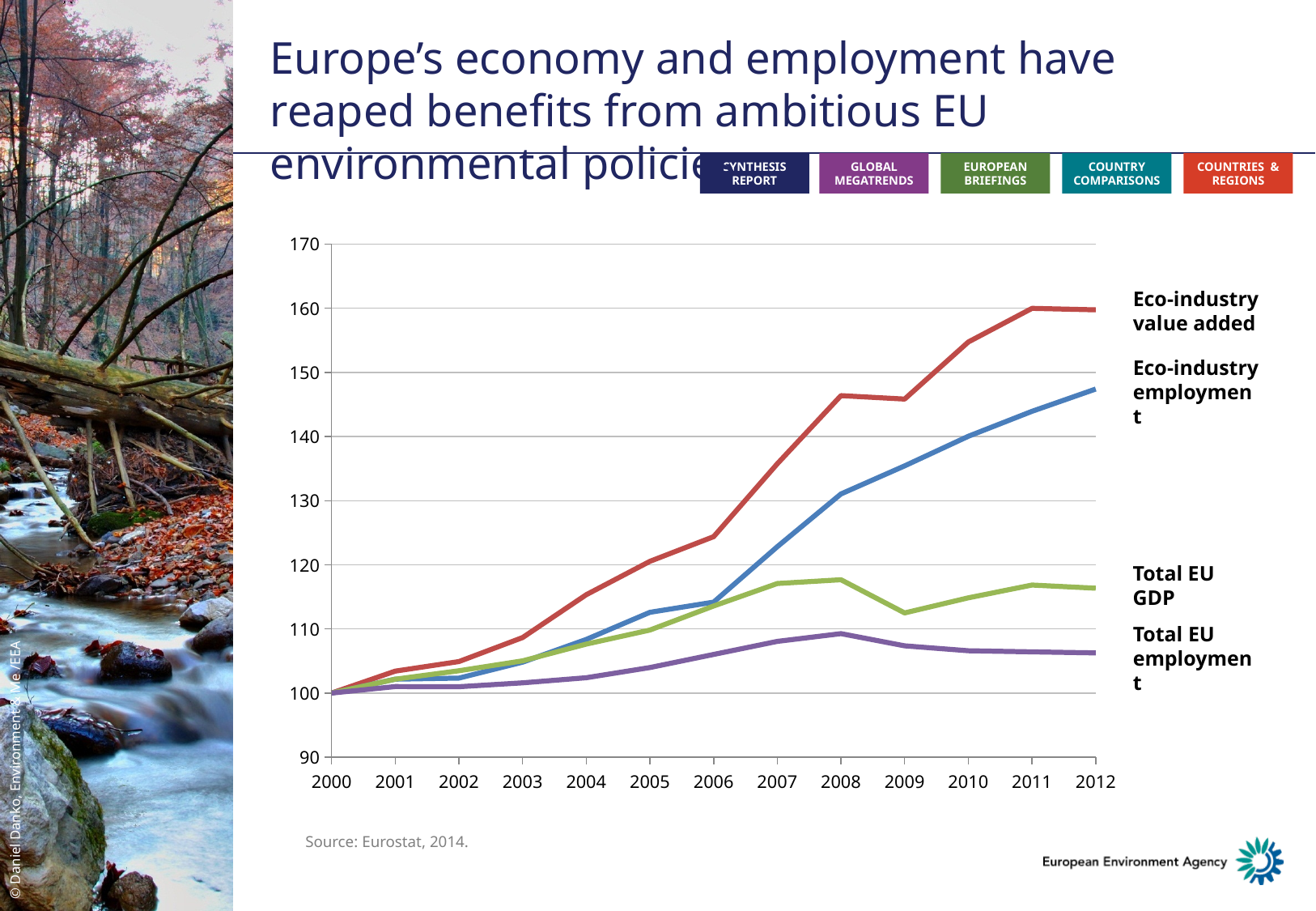
Is the value for Eco-industry employment in 2012 greater or less than 140? greater What kind of chart is shown on the slide? Line chart Which series has the highest value in 2012? Eco-industry value added Which series has the lowest value in 2012? Total EU employment Does Eco-industry value added rise or fall overall from 2000 to 2012? Rise How many series does the chart show? 4 Is the value for Eco-industry value added in 2012 greater or less than 150? greater In 2012, which is larger: Eco-industry employment or Total EU GDP? Eco-industry employment Is the value for Total EU GDP in 2008 greater or less than 120? less What source is cited below the chart? Eurostat, 2014 How many years are marked along the x axis of the chart? 13 What is the value of Eco-industry value added in 2000? 100